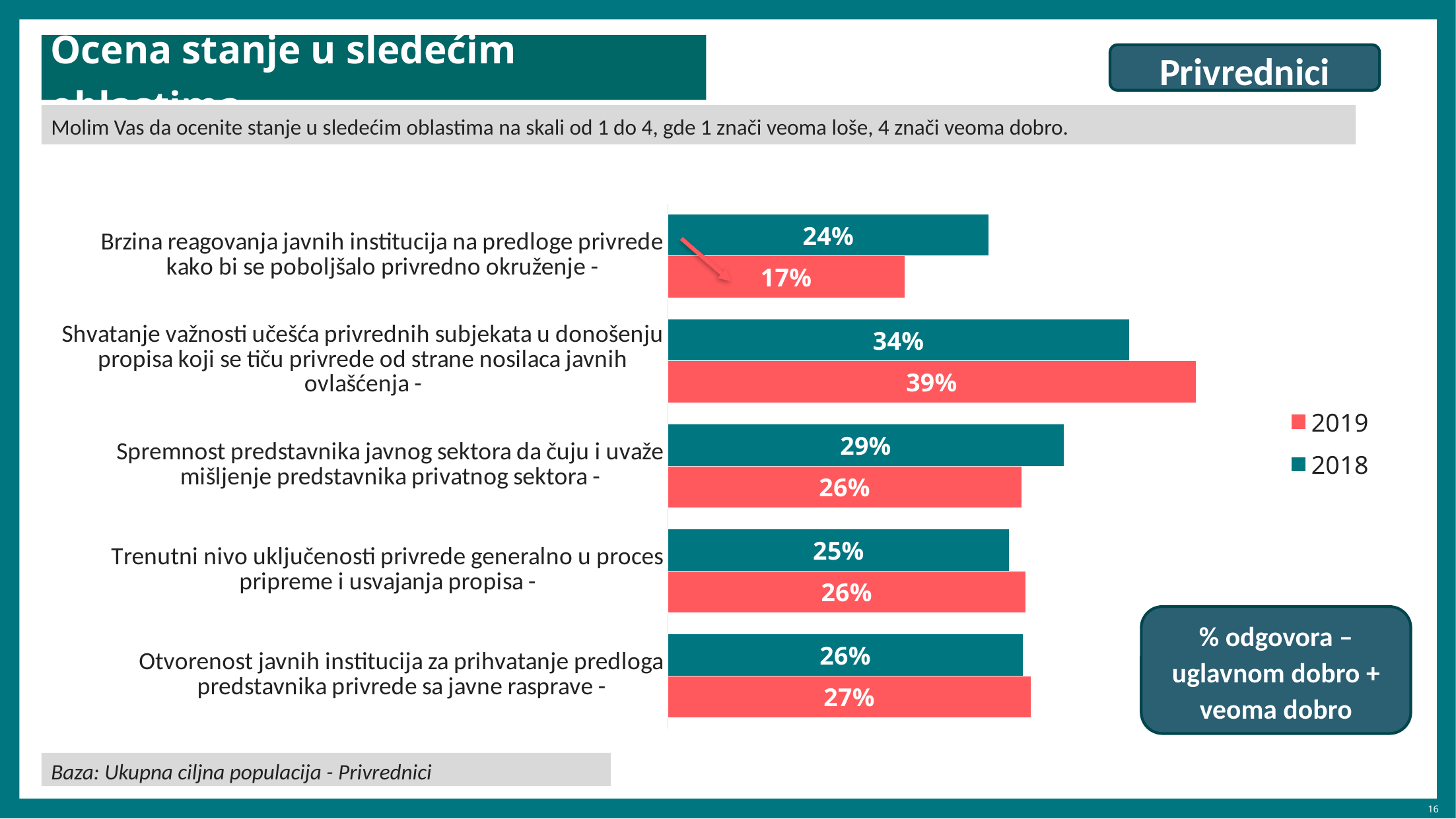
What is the 2019 value for "Spremnost predstavnika javnog sektora da čuju i uvaže mišljenje predstavnika privatnog sektora"? 26% What is the 2019 value for "Brzina reagovanja javnih institucija na predloge privrede kako bi se poboljšalo privredno okruženje"? 17% What is the difference between the 2019 and 2018 values for "Shvatanje važnosti učešća privrednih subjekata u donošenju propisa koji se tiču privrede od strane nosilaca javnih ovlašćenja"? 5% What is the difference between the 2018 and 2019 values for "Brzina reagovanja javnih institucija na predloge privrede kako bi se poboljšalo privredno okruženje"? 7% Which category has the lowest 2019 value? Brzina reagovanja javnih institucija na predloge privrede kako bi se poboljšalo privredno okruženje How many series does the legend list? 2 What kind of chart is shown on the slide? Bar chart What is the 2018 value for "Otvorenost javnih institucija za prihvatanje predloga predstavnika privrede sa javne rasprave"? 26% For "Spremnost predstavnika javnog sektora da čuju i uvaže mišljenje predstavnika privatnog sektora", which year has the larger value, 2018 or 2019? 2018 What is the 2018 value for "Shvatanje važnosti učešća privrednih subjekata u donošenju propisa koji se tiču privrede od strane nosilaca javnih ovlašćenja"? 34% Which category has the highest 2019 value? Shvatanje važnosti učešća privrednih subjekata u donošenju propisa koji se tiču privrede od strane nosilaca javnih ovlašćenja How many categories are shown in the chart? 5